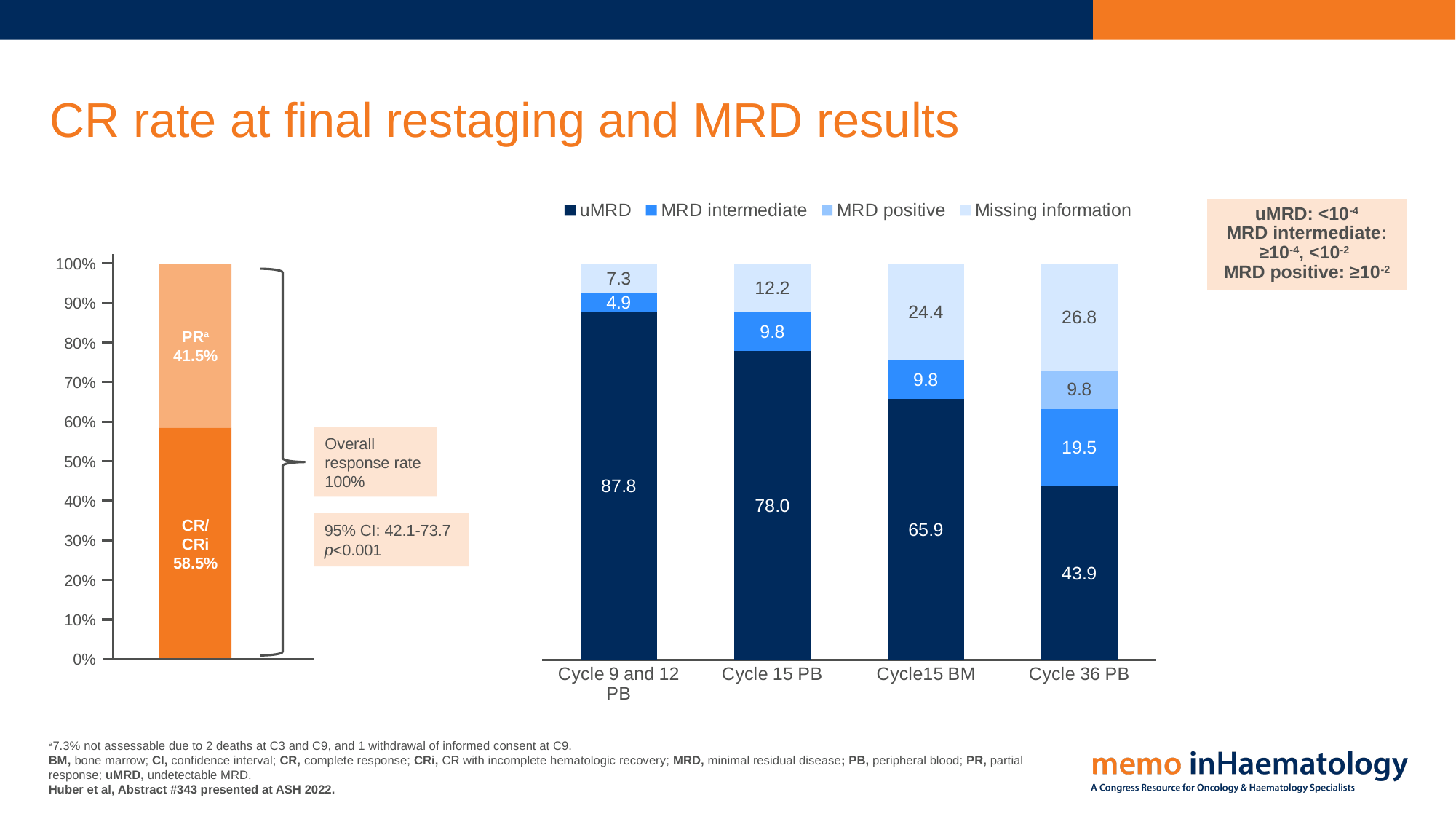
In the right-hand MRD chart, which category has the highest uMRD value? Cycle 9 and 12 PB In the right-hand MRD chart, what is the uMRD value for Cycle 15 PB? 78.0 In the right-hand MRD chart, does the uMRD value rise or fall from Cycle 9 and 12 PB to Cycle 36 PB? Fall In the right-hand MRD chart, what is the difference between the uMRD values for Cycle 15 PB and Cycle15 BM? 12.1 What kind of chart is the right-hand MRD chart? Stacked bar chart How many categories are shown on the x axis of the right-hand MRD chart? 4 In the right-hand MRD chart, is the Missing information value larger for Cycle15 BM or for Cycle 36 PB? Cycle 36 PB In the left-hand response chart, what is the CR/CRi value? 58.5% In the right-hand MRD chart, which category has the lowest uMRD value? Cycle 36 PB How many series does the legend of the right-hand MRD chart list? 4 In the left-hand response chart, what is the difference between the CR/CRi and PR values? 17.0% In the right-hand MRD chart, what is the Missing information value for Cycle 36 PB? 26.8